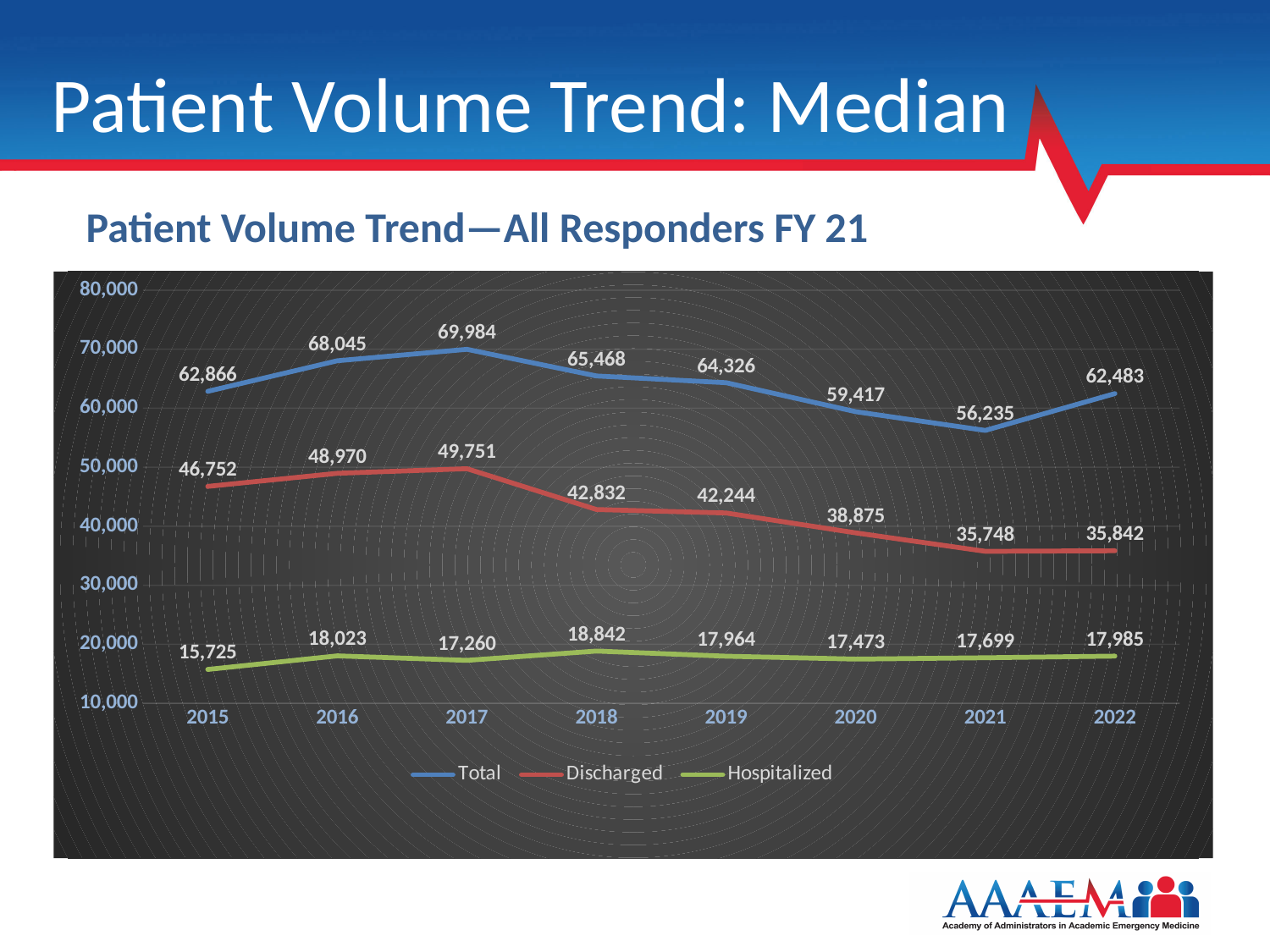
What is the Hospitalized value for 2015? 15,725 What is the difference between the Total values for 2017 and 2021? 13,749 How many series does the legend list? 3 In which year is the Hospitalized series highest? 2018 How many years are shown on the x axis? 8 In which year is the Total series lowest? 2021 Does the Discharged series rise or fall from 2017 to 2021? fall In which year is the Total series highest? 2017 What is the Total value for 2017? 69,984 What kind of chart is shown? line chart What is the Discharged value for 2020? 38,875 Which is larger, the Discharged value for 2016 or for 2019? 2016